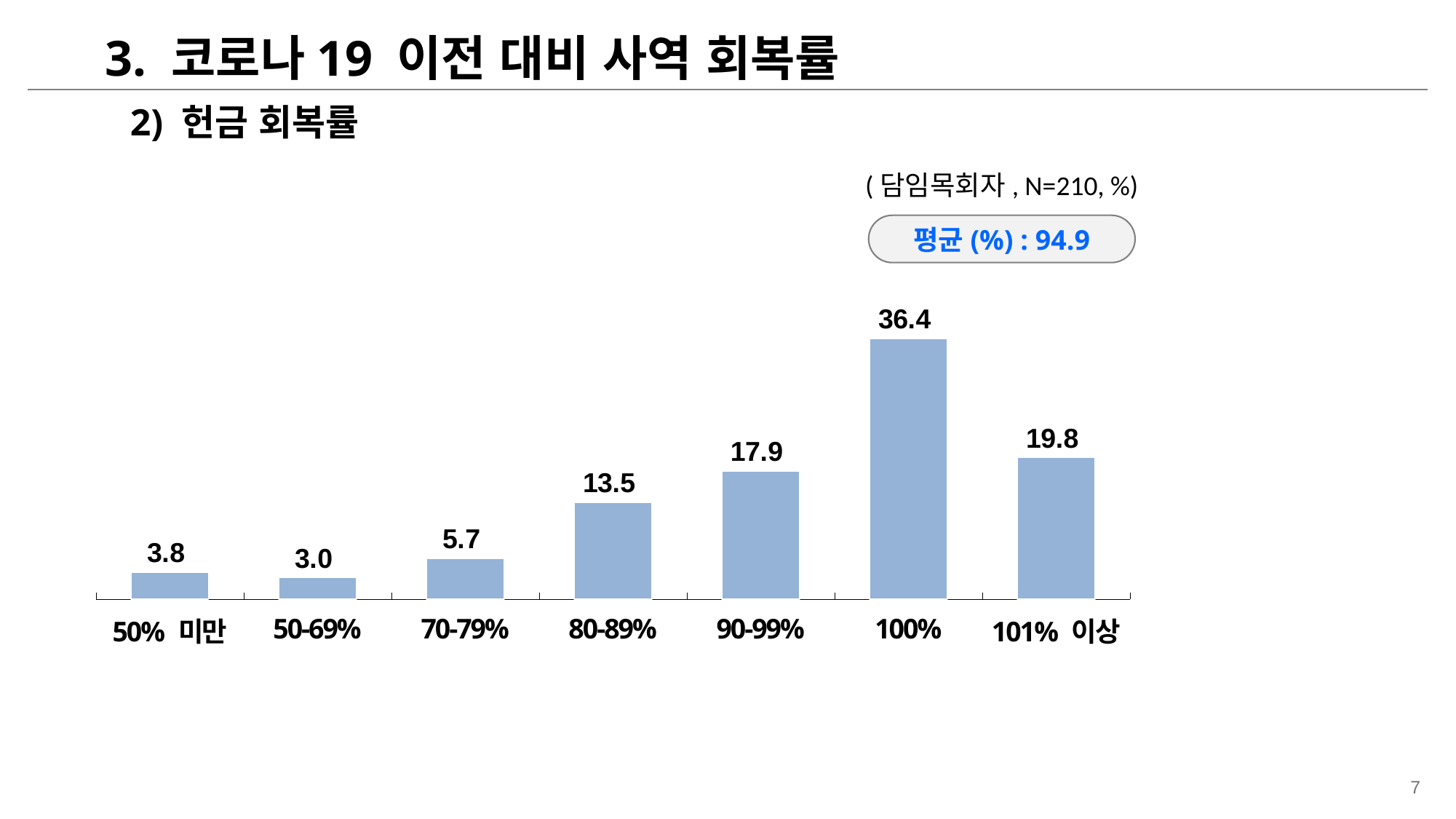
How many categories are shown on the x axis? 7 What is the difference between the values for 90-99% and 80-89%? 4.4 What is the value for the 80-89% category? 13.5 Which is larger, the value for 50% 미만 or the value for 70-79%? 70-79% Which category has the highest value? 100% What is the sample size (N) stated on the slide? 210 What average (평균) value is shown in the box above the chart? 94.9 Which category has the lowest value? 50-69% What is the value for the 100% category? 36.4 What is the difference between the values for 100% and 101% 이상? 16.6 What is the value for the 50-69% category? 3.0 What kind of chart is shown on the slide? bar chart